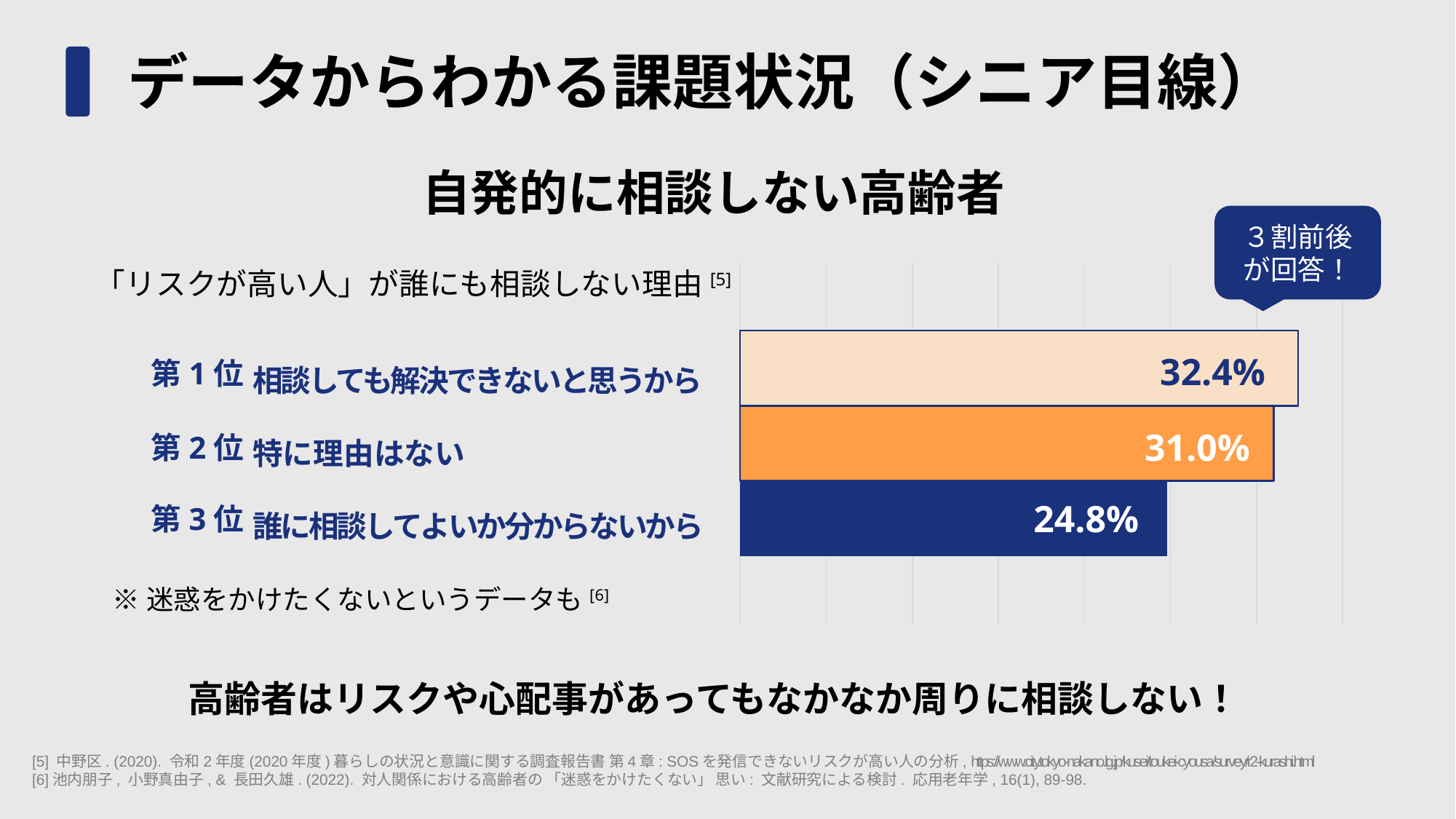
What is the value for 「誰に相談してよいか分からないから」? 24.8% Which reason is ranked 第2位? 特に理由はない Which reason has the lowest value? 誰に相談してよいか分からないから What is the difference between the values for 「特に理由はない」 and 「誰に相談してよいか分からないから」? 6.2% How many reasons (bars) are shown in the chart? 3 Which reason has the highest value? 相談しても解決できないと思うから What is the value for 「相談しても解決できないと思うから」? 32.4% Which is larger, the value for 「特に理由はない」 or the value for 「誰に相談してよいか分からないから」? 特に理由はない What is the difference between the values for 「相談しても解決できないと思うから」 and 「誰に相談してよいか分からないから」? 7.6% What colour is the bar for 「誰に相談してよいか分からないから」? Dark blue What kind of chart is shown on the slide? Bar chart What is the value for 「特に理由はない」? 31.0%